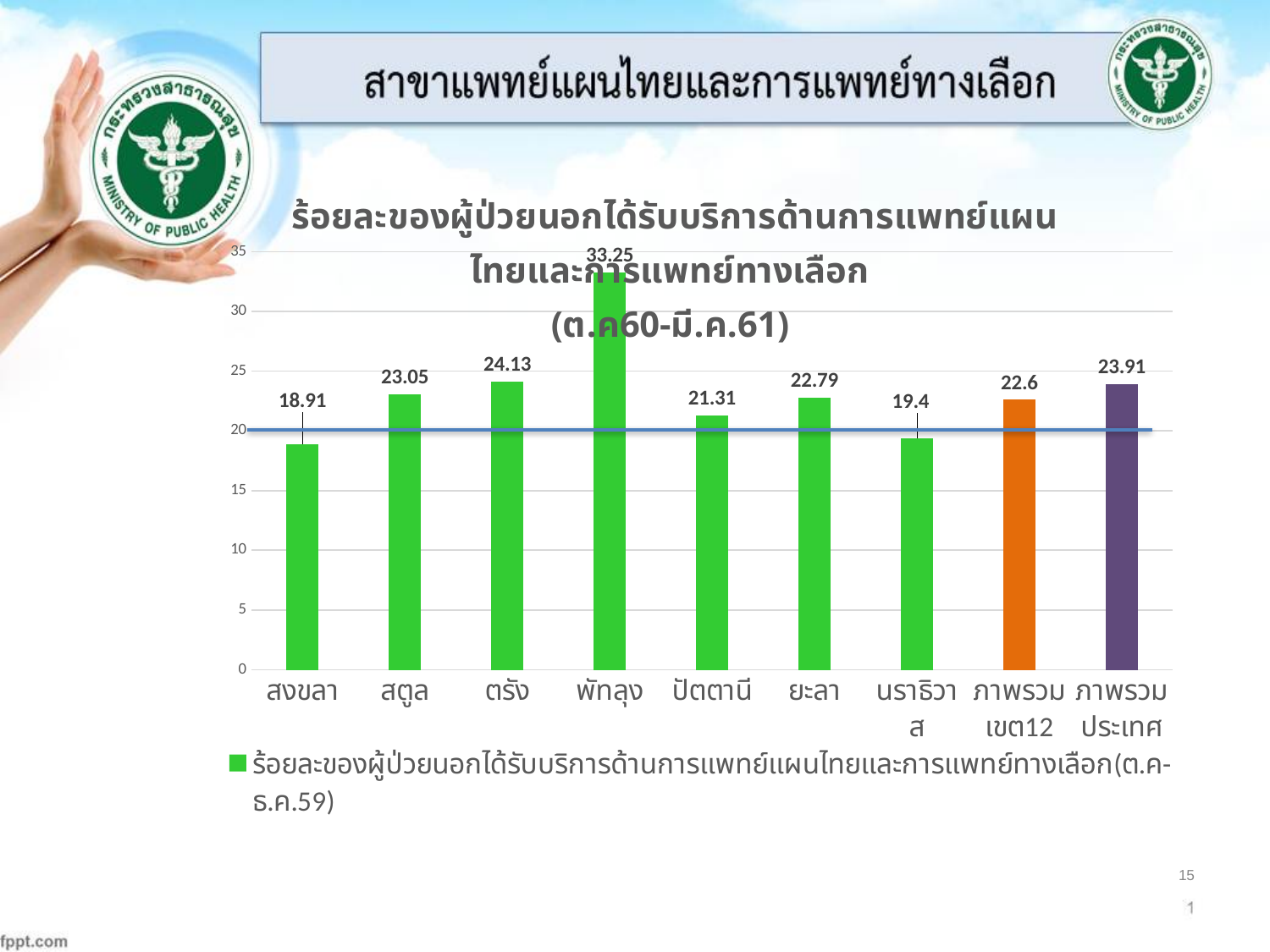
Which category has the highest value? พัทลุง How many categories are shown on the x axis? 9 What is the value for ภาพรวมเขต12? 22.6 What colour is the bar for ภาพรวมเขต12? orange What is the value for ภาพรวมประเทศ? 23.91 What is the difference between the values for พัทลุง and สงขลา? 14.34 Which is larger, the value for ตรัง or the value for ปัตตานี? ตรัง Which category has the lowest value? สงขลา What is the value for พัทลุง? 33.25 What is the value for สงขลา? 18.91 What kind of chart is shown on the slide? bar chart Is the value for นราธิวาส greater or less than 20? less